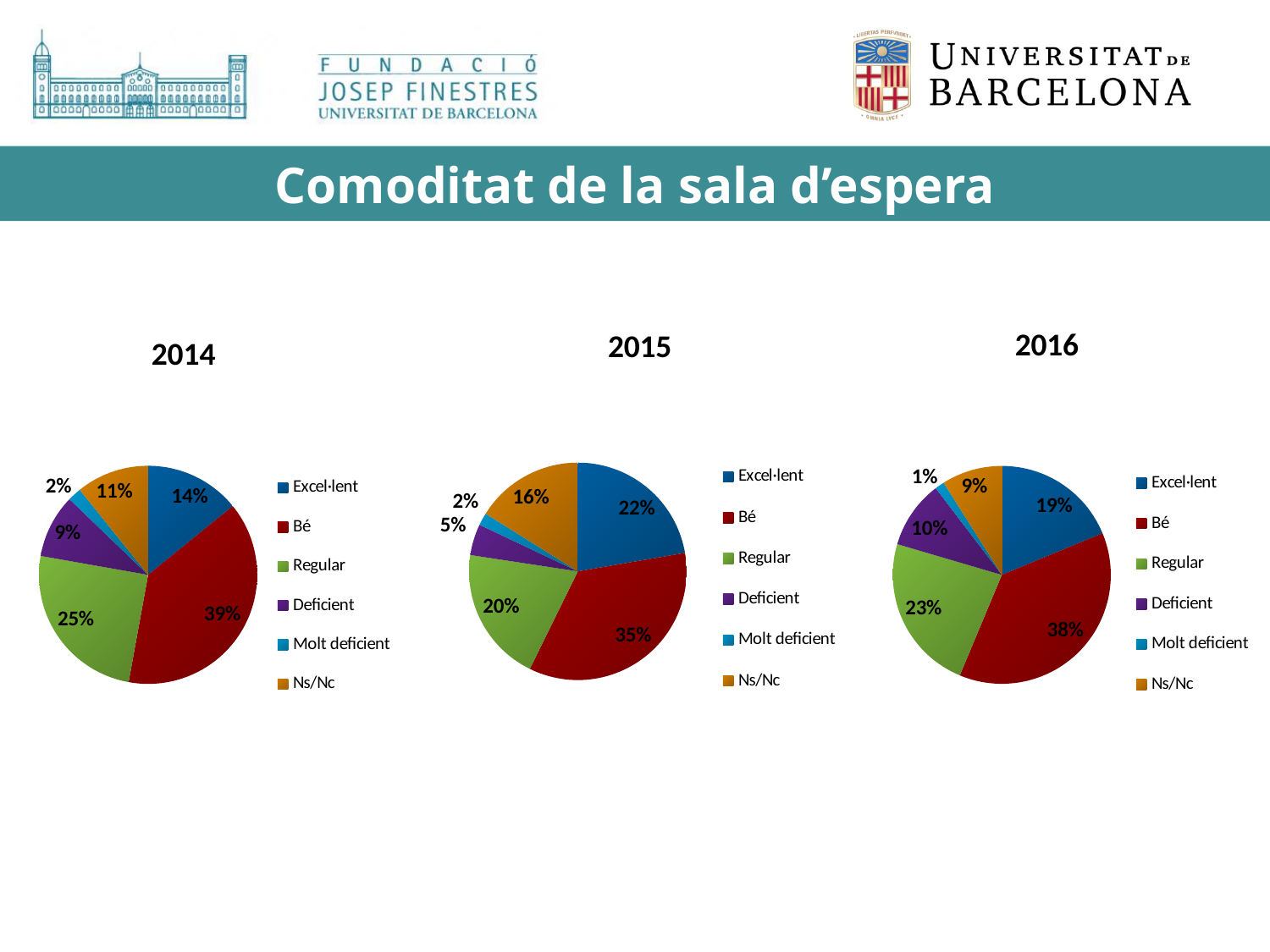
In the 2014 chart, what is the difference between the Regular and Excel·lent shares? 11% In the 2016 chart, which is larger, Deficient or Ns/Nc? Deficient In the 2015 chart, what share does Excel·lent have? 22% How many pie charts are shown on the slide? 3 In the 2016 chart, what share does Regular have? 23% In the 2014 chart, what share does Ns/Nc have? 11% In the 2015 chart, how many categories are shown in the legend? 6 In the 2014 chart, what share does Bé have? 39% In the 2016 chart, which category has the largest slice? Bé What type of chart is used for the 2014 data? Pie chart In the 2016 chart, what share does Molt deficient have? 1% In the 2015 chart, which category has the smallest slice? Molt deficient